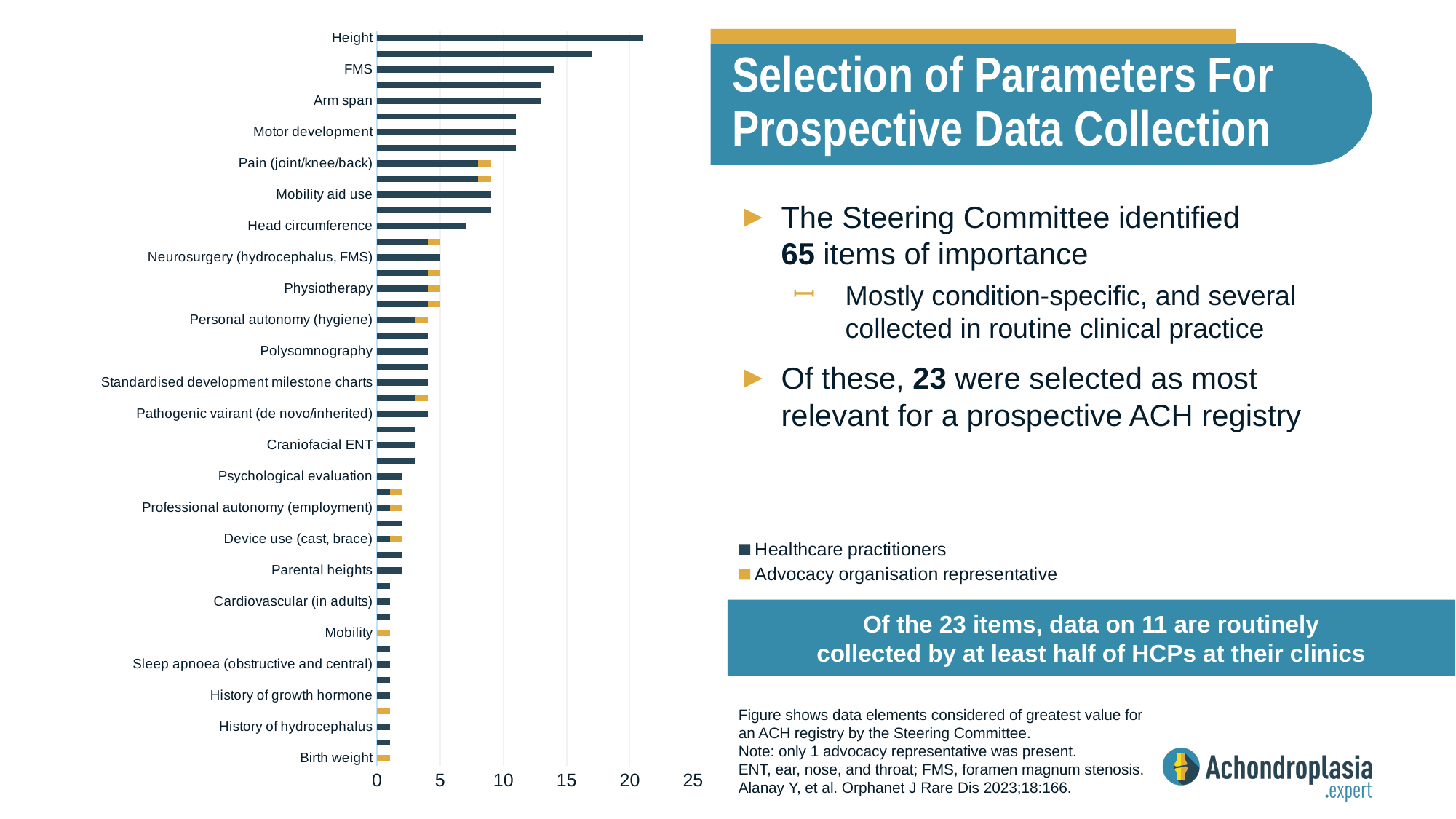
Which series is shown in orange in the chart legend? Advocacy organisation representative What kind of chart is shown on the slide? bar chart Is the value for Neurosurgery (hydrocephalus, FMS) greater or less than 10? less Which is larger, the value for Height or the value for FMS? Height Is the value for Psychological evaluation greater or less than 5? less Is the value for Height greater or less than 15? greater How many series does the chart legend list? 2 Which is larger, the value for Arm span or the value for Head circumference? Arm span Which category has the highest value in the chart? Height Which series is shown in dark blue in the chart legend? Healthcare practitioners